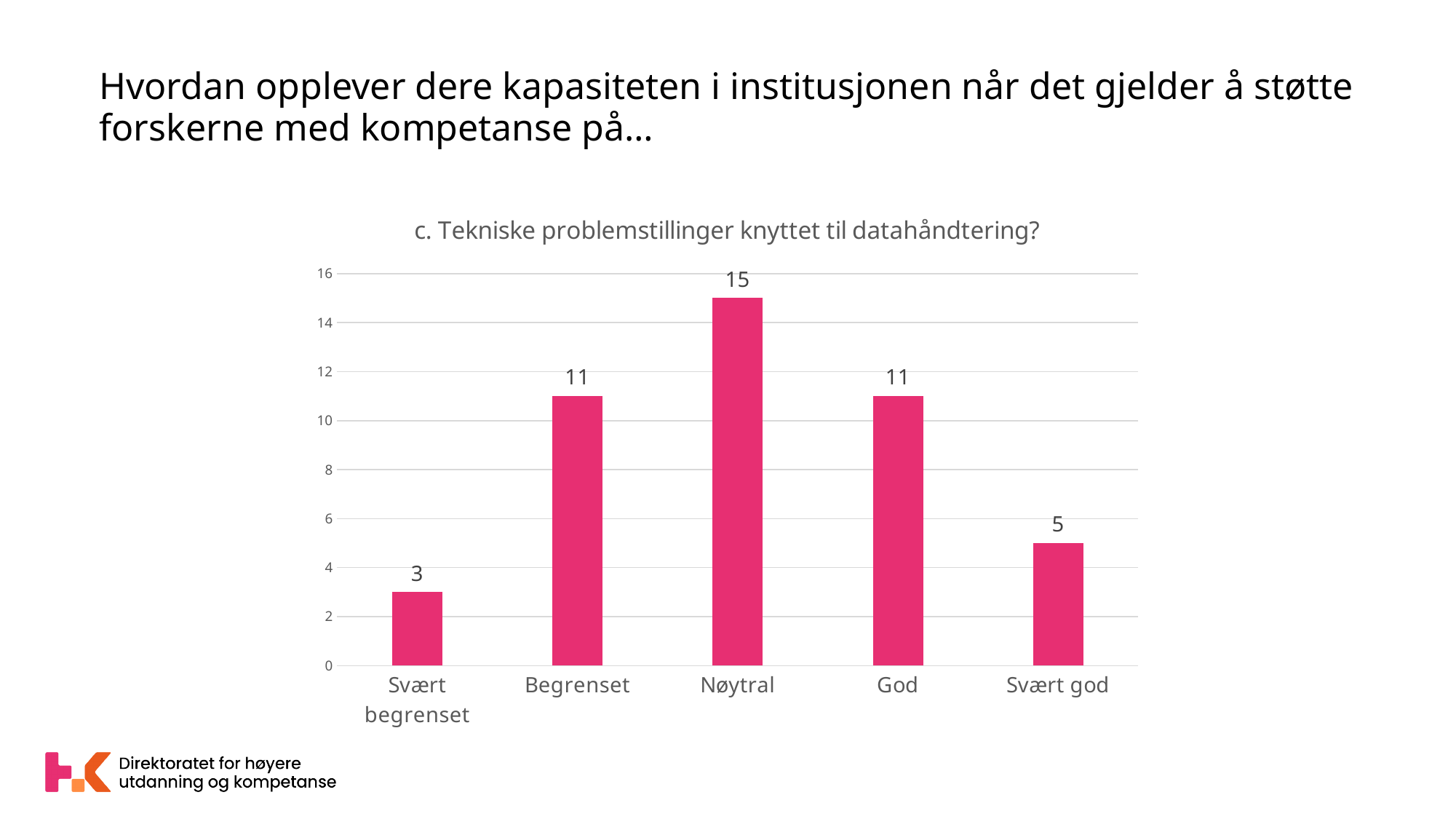
What is the value for Nøytral? 15 Which is larger, the value for Begrenset or the value for Svært god? Begrenset What is the value for Svært god? 5 What is the difference between the values for Nøytral and God? 4 What is the value for Svært begrenset? 3 Which category has the lowest value? Svært begrenset Which category has the highest value? Nøytral What is the title of the chart? c. Tekniske problemstillinger knyttet til datahåndtering? How many categories are shown on the x axis? 5 What is the difference between the values for Svært god and Svært begrenset? 2 What is the value for Begrenset? 11 What kind of chart is shown on the slide? Bar chart